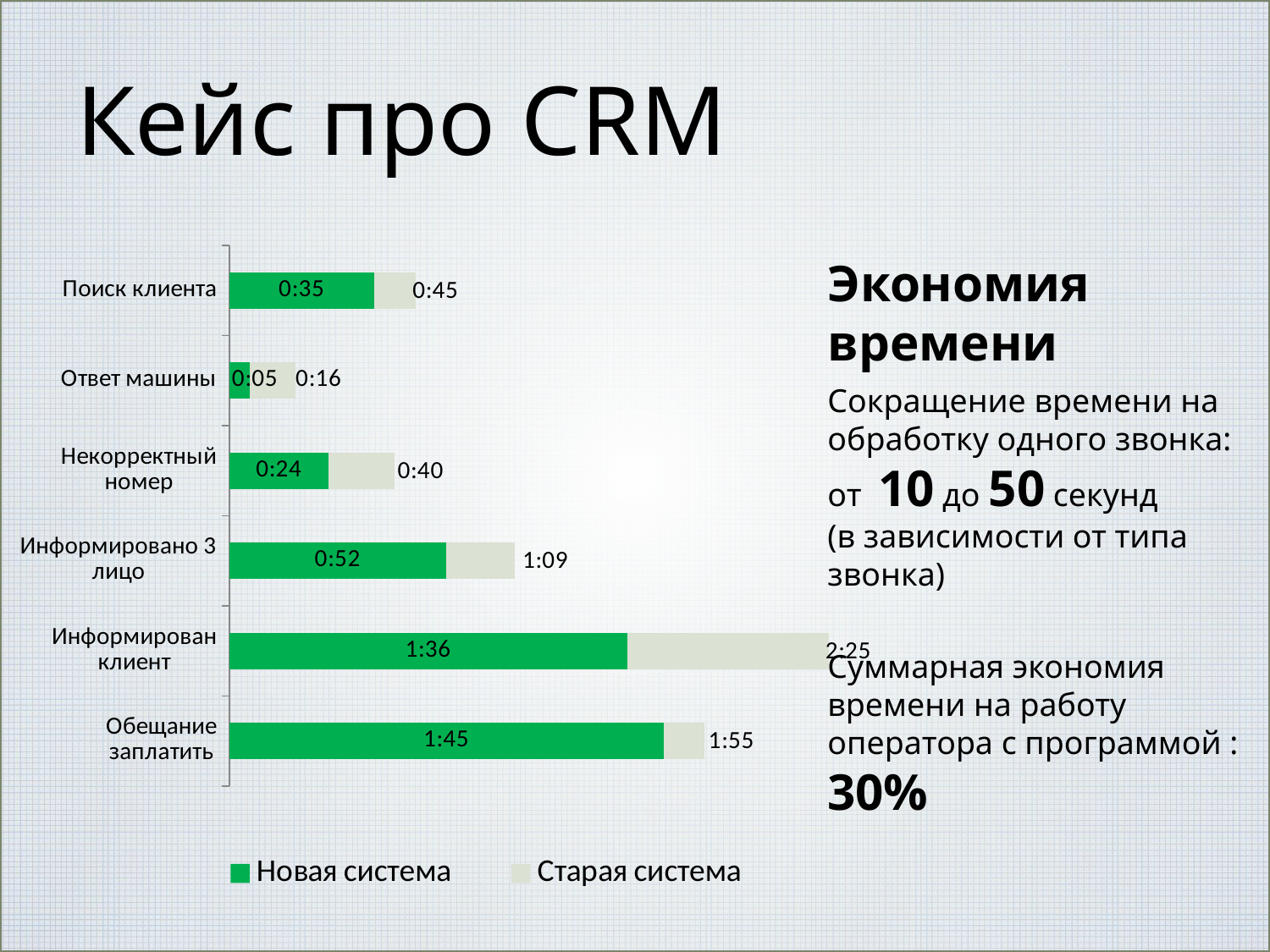
How many categories are shown on the chart? 6 What is the value for Поиск клиента in the Новая система series? 0:35 What is the value for Информировано 3 лицо in the Новая система series? 0:52 What kind of chart is shown on the slide? Bar chart Which category has the lowest value in the Новая система series? Ответ машины How many series does the legend list? 2 What is the value for Некорректный номер in the Старая система series? 0:40 Which category has the highest value in the Старая система series? Информирован клиент Which is larger for Ответ машины: the Новая система value or the Старая система value? Старая система Which category has the highest value in the Новая система series? Обещание заплатить What is the value for Информирован клиент in the Старая система series? 2:25 What is the difference between the Старая система and Новая система values for Информирован клиент? 0:49